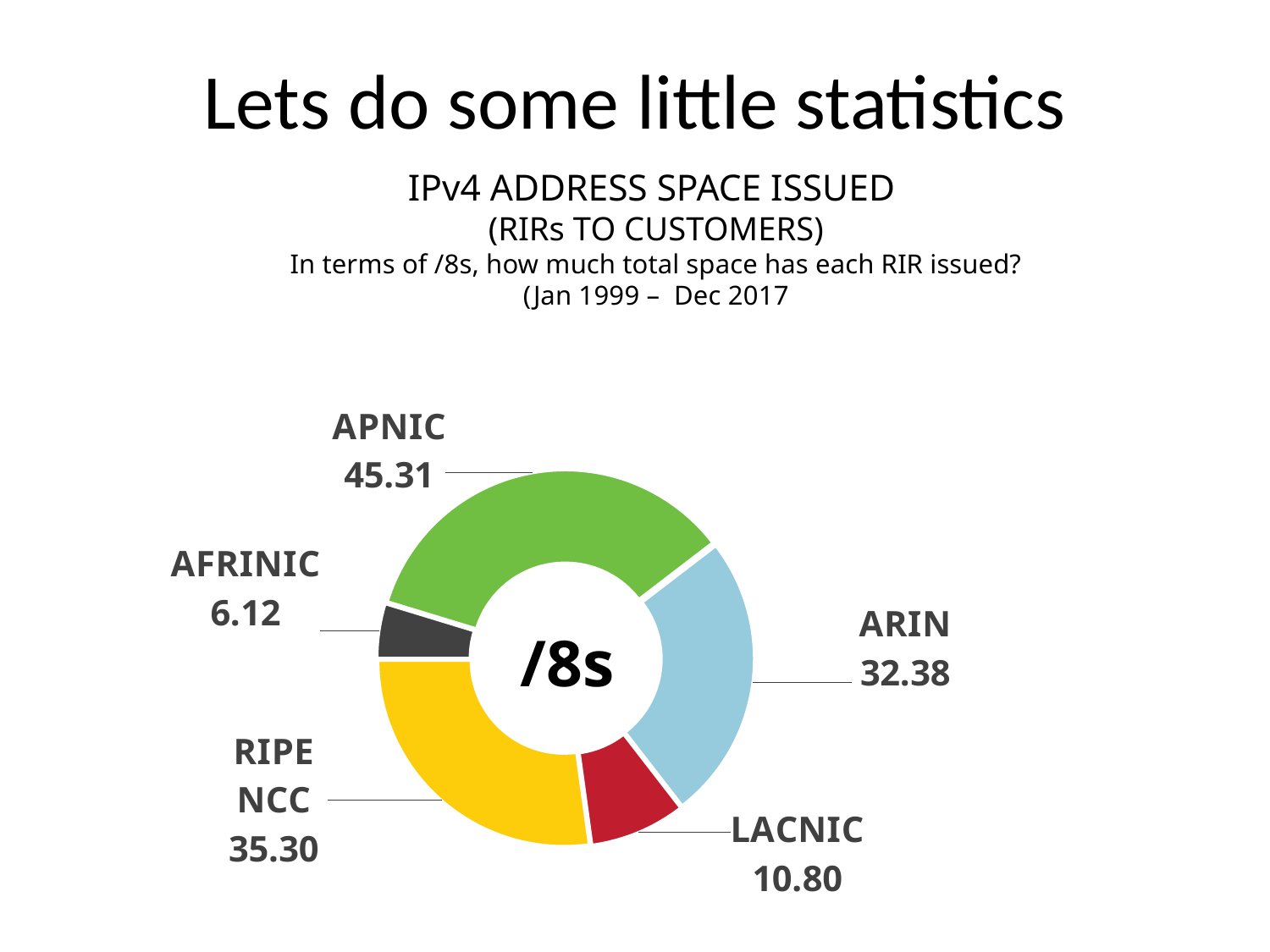
What value is shown for LACNIC in the chart? 10.80 Which RIR has the largest value in the chart? APNIC What is the difference between the values for APNIC and ARIN? 12.93 What value is shown for APNIC in the chart? 45.31 What kind of chart is shown on the slide? doughnut (pie) chart What is the difference between the values for RIPE NCC and LACNIC? 24.50 How many RIRs (categories) are shown in the chart? 5 What text is printed in the centre of the doughnut chart? /8s Which is larger, the value for ARIN or the value for RIPE NCC? RIPE NCC What value is shown for RIPE NCC in the chart? 35.30 Which RIR has the smallest value in the chart? AFRINIC What is the total of all the values shown in the chart? 129.91